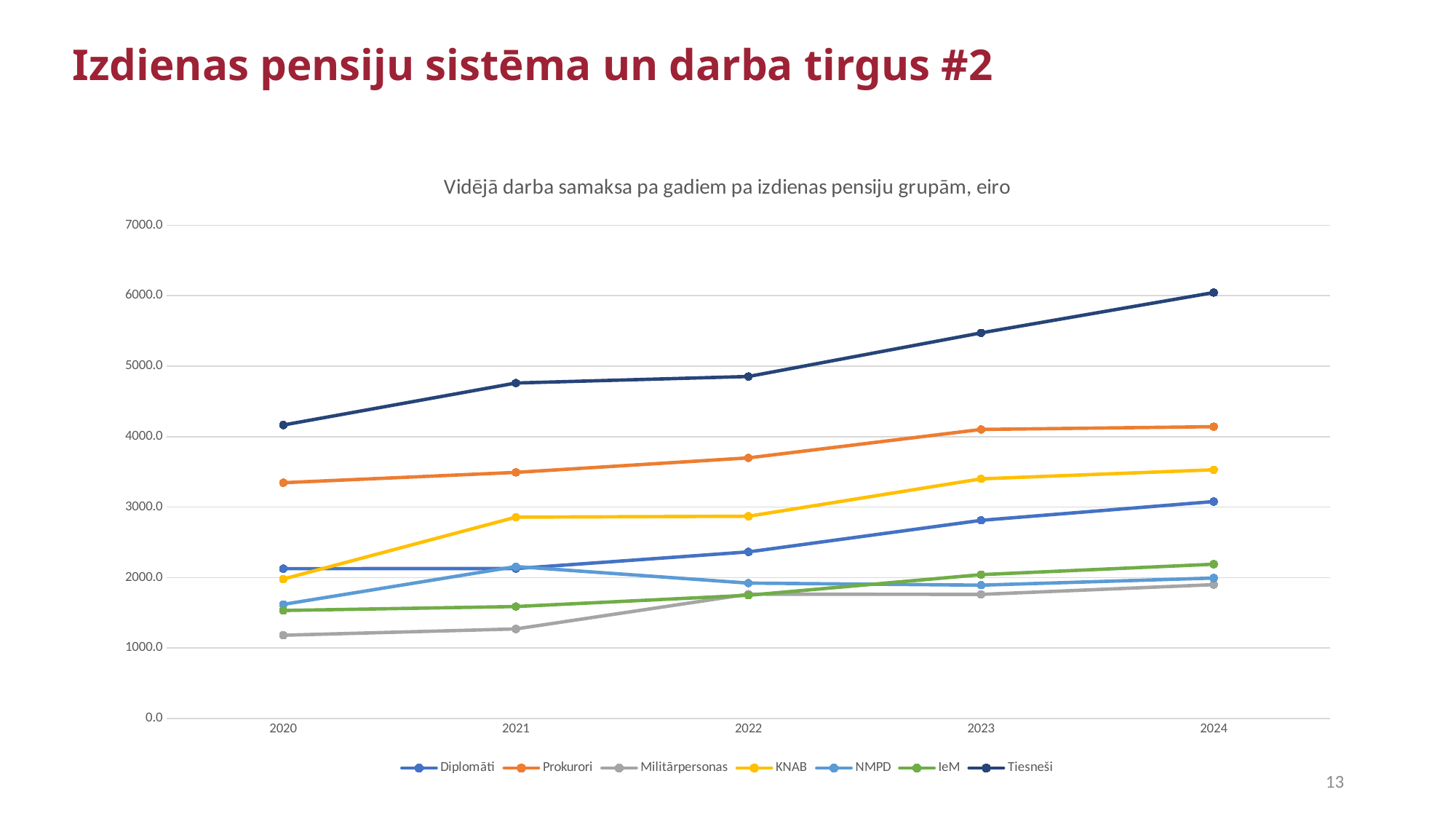
Which group has the lowest average pay in 2020? Militārpersonas What is the title of the chart? Vidējā darba samaksa pa gadiem pa izdienas pensiju grupām, eiro Is the value for Prokurori in 2020 greater or less than 3000? greater Does the value for Tiesneši rise or fall from 2020 to 2024? rise How many years are plotted along the x axis? 5 Which group has the highest average pay in 2024? Tiesneši Is the value for Tiesneši in 2023 greater or less than 5000? greater What kind of chart is shown on the slide? line chart In 2024, which is larger: the value for Prokurori or the value for KNAB? Prokurori Is the value for Militārpersonas in 2021 greater or less than 2000? less How many series does the legend list? 7